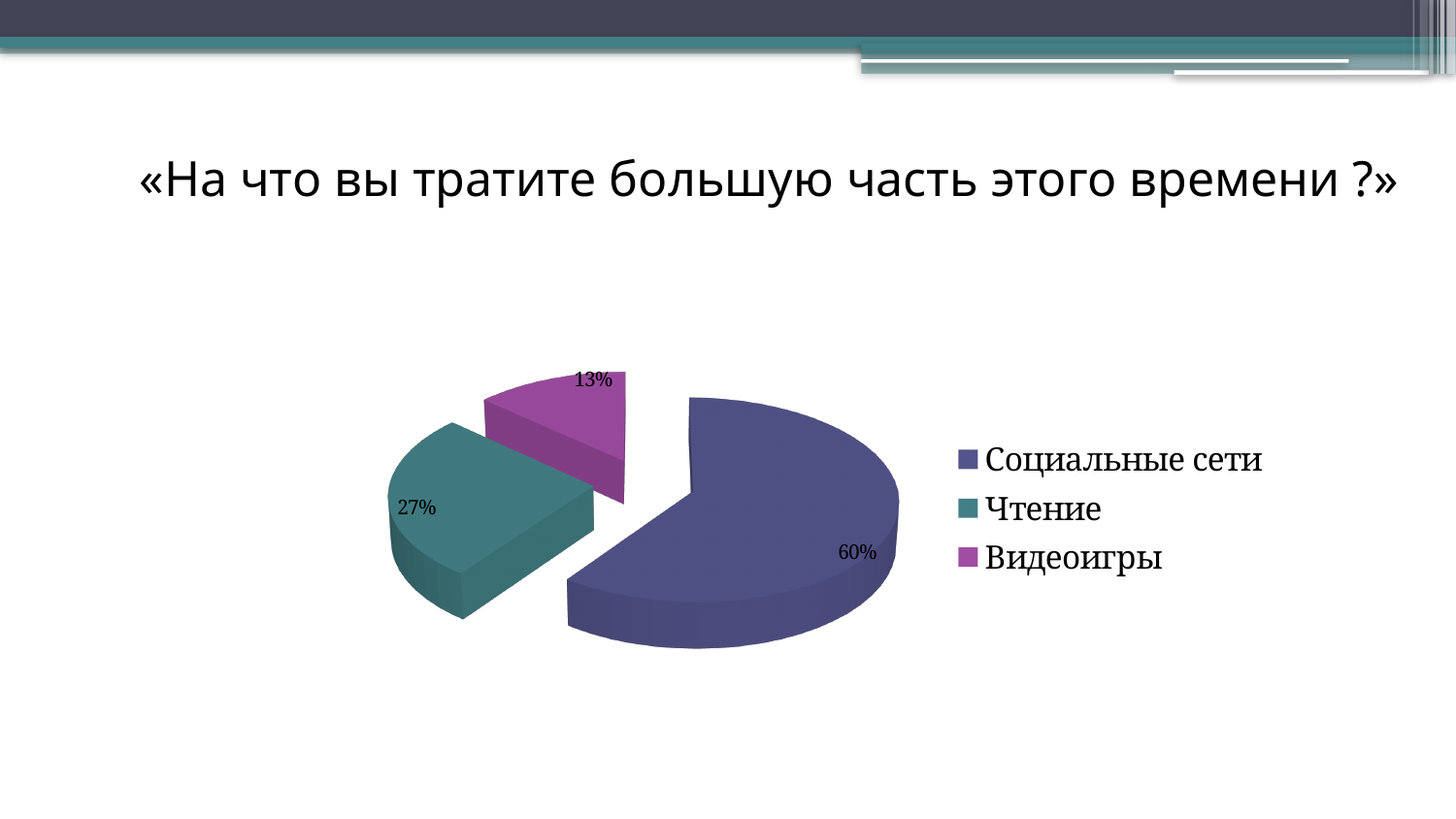
Which category has the largest slice of the pie? Социальные сети What share of the pie does Социальные сети have? 60% What is the difference in percentage points between Социальные сети and Чтение? 33 Which category is shown in purple/magenta in the legend? Видеоигры What kind of chart is shown on the slide? Pie chart What share of the pie does Видеоигры have? 13% What is the difference in percentage points between Чтение and Видеоигры? 14 Which category has the smallest slice of the pie? Видеоигры What is the title of the slide above the chart? «На что вы тратите большую часть этого времени ?» Which is larger, the share for Чтение or the share for Видеоигры? Чтение What share of the pie does Чтение have? 27% How many categories does the pie chart show? 3